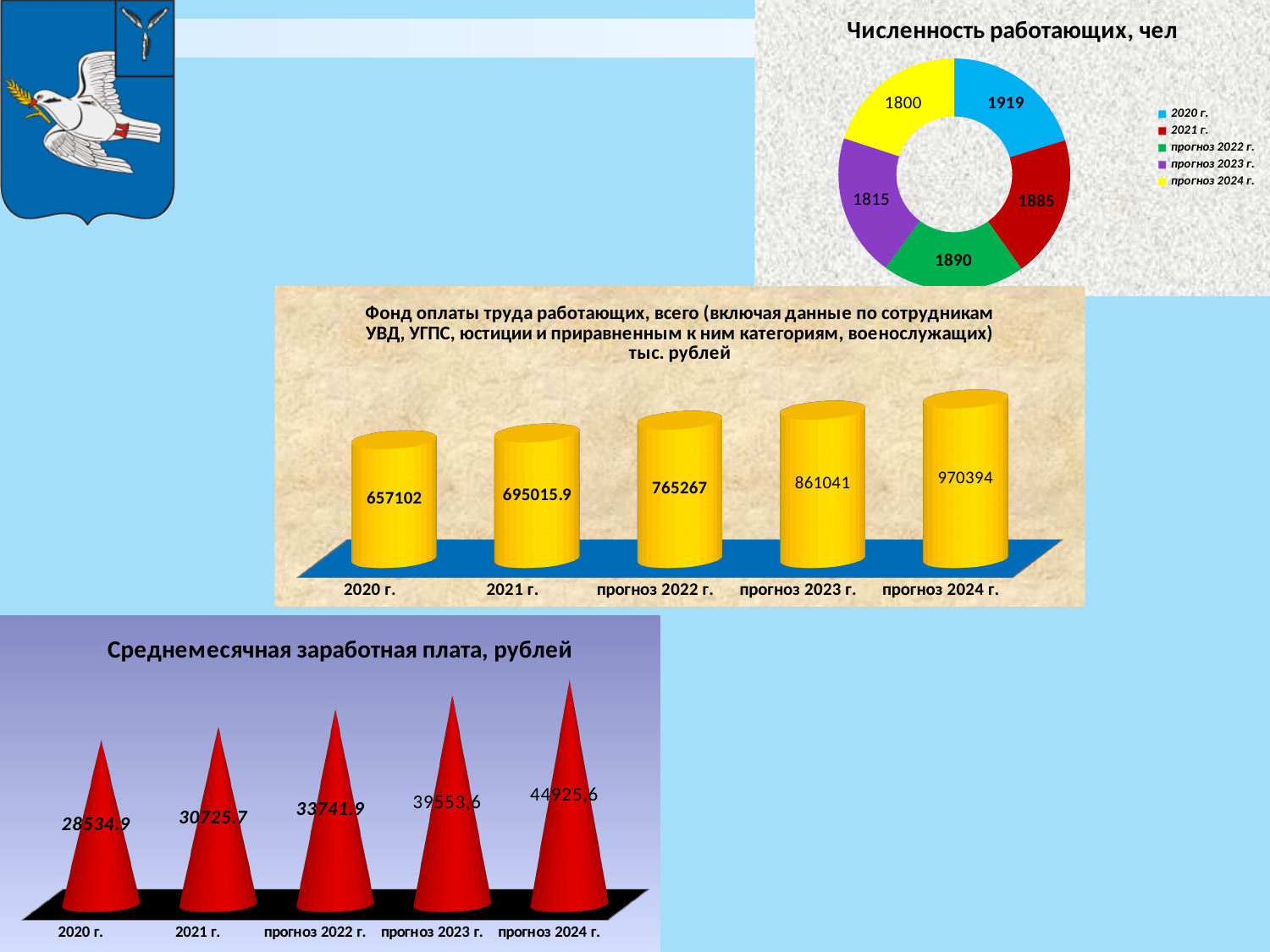
In the chart 'Фонд оплаты труда работающих', which category has the highest value? прогноз 2024 г. In the chart 'Численность работающих, чел', how many entries does the legend list? 5 In the chart 'Численность работающих, чел', what is the value for 2020 г.? 1919 In the chart 'Численность работающих, чел', what is the difference between the values for 2020 г. and 2021 г.? 34 In the chart 'Фонд оплаты труда работающих', do the values rise or fall from 2020 г. to прогноз 2024 г.? Rise What kind of chart is 'Численность работающих, чел'? Doughnut chart In the chart 'Среднемесячная заработная плата, рублей', which is larger: the value for 2021 г. or the value for прогноз 2023 г.? прогноз 2023 г. In the chart 'Фонд оплаты труда работающих', how many categories are shown? 5 In the chart 'Среднемесячная заработная плата, рублей', what is the value for прогноз 2022 г.? 33741.9 In the chart 'Фонд оплаты труда работающих', what is the value for прогноз 2023 г.? 861041 In the chart 'Среднемесячная заработная плата, рублей', what is the value for прогноз 2024 г.? 44925,6 In the chart 'Численность работающих, чел', which year has the lowest value? прогноз 2024 г.